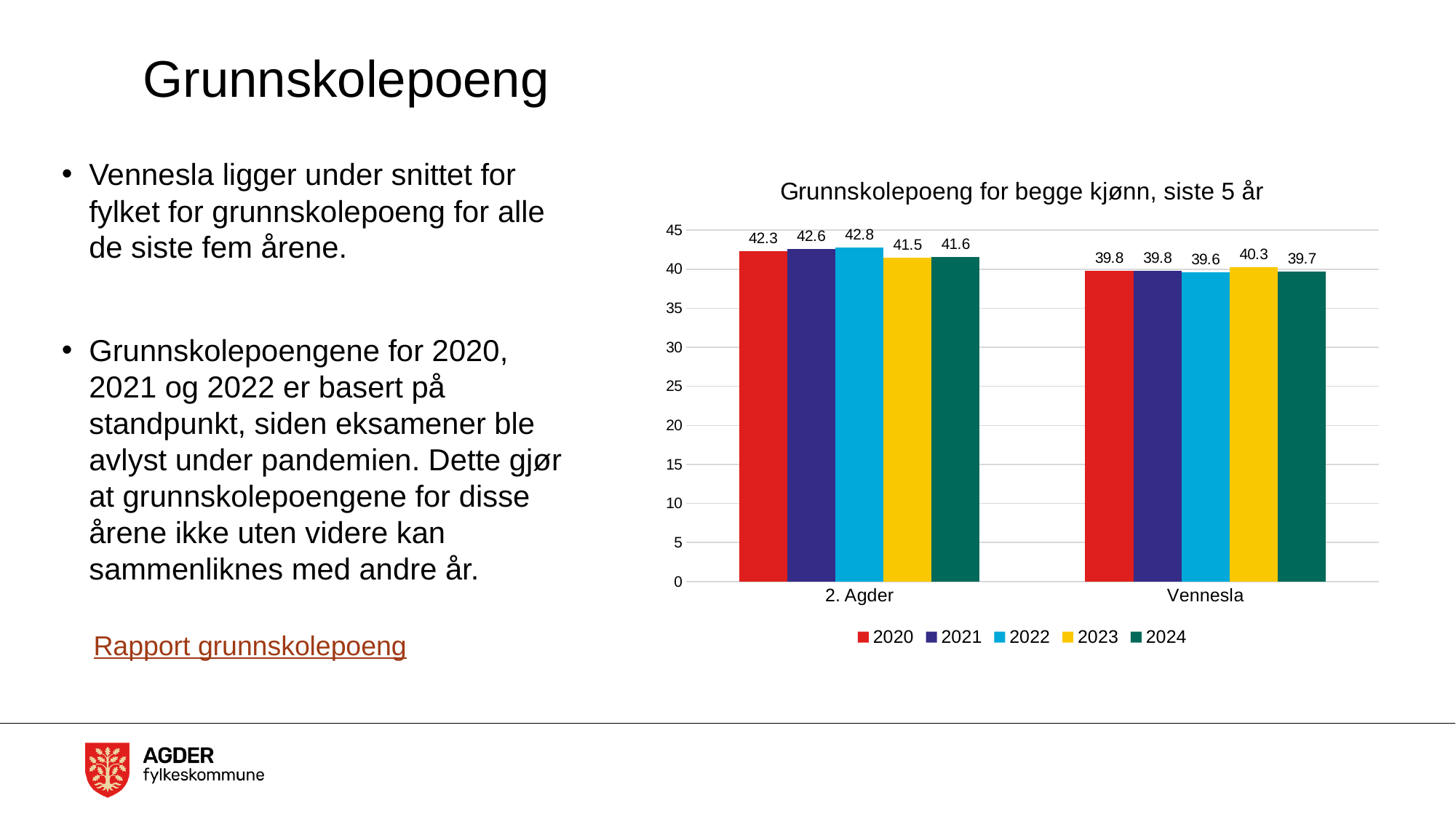
Is the value for Vennesla in 2021 greater or less than 40? less What is the value for Vennesla in 2023? 40.3 Which year has the lowest value for Vennesla? 2022 How many categories are shown on the x axis? 2 How many series does the legend list? 5 What is the title of the chart? Grunnskolepoeng for begge kjønn, siste 5 år What is the value for 2. Agder in 2022? 42.8 What kind of chart is shown? bar chart Which year has the highest value for 2. Agder? 2022 What is the difference between the 2024 values for 2. Agder and Vennesla? 1.9 Which is larger, the 2023 value for 2. Agder or the 2023 value for Vennesla? 2. Agder What is the value for Vennesla in 2020? 39.8